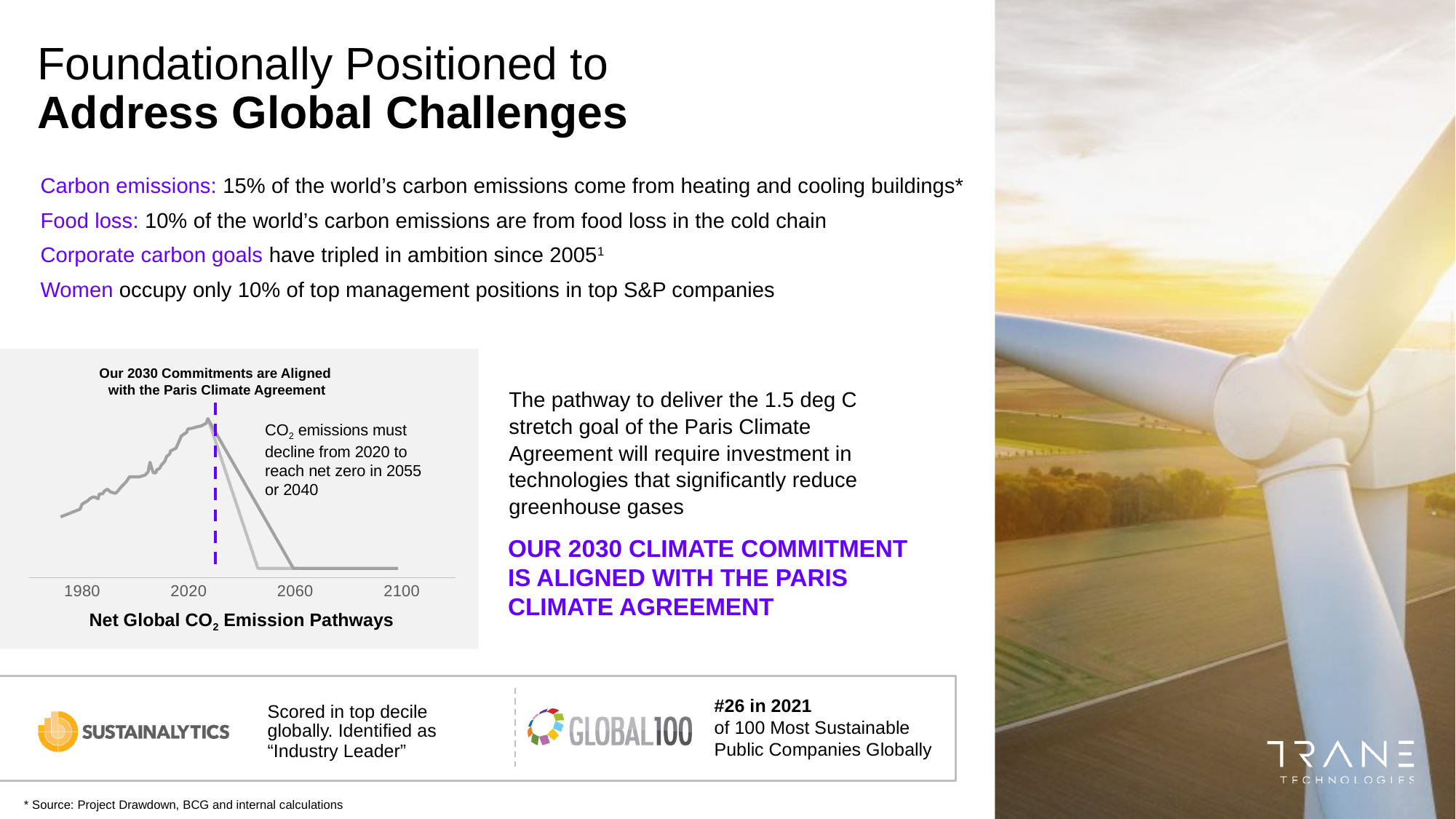
In the Net Global CO2 Emission Pathways chart, do the pathway lines rise or fall after 2020? Fall What kind of chart is shown under the title "Our 2030 Commitments are Aligned with the Paris Climate Agreement"? Line chart According to the annotation on the chart, in which years must CO2 emissions reach net zero? 2055 or 2040 What is the last year labelled on the x axis of the Net Global CO2 Emission Pathways chart? 2100 What is the first year labelled on the x axis of the Net Global CO2 Emission Pathways chart? 1980 What is the title printed above the line chart on the slide? Our 2030 Commitments are Aligned with the Paris Climate Agreement In the Net Global CO2 Emission Pathways chart, do emissions rise or fall between 1980 and 2020? Rise How many year labels are shown on the x axis of the Net Global CO2 Emission Pathways chart? 4 What label is printed below the x axis of the line chart? Net Global CO2 Emission Pathways How many emission pathway lines are plotted after 2020 in the Net Global CO2 Emission Pathways chart? 2